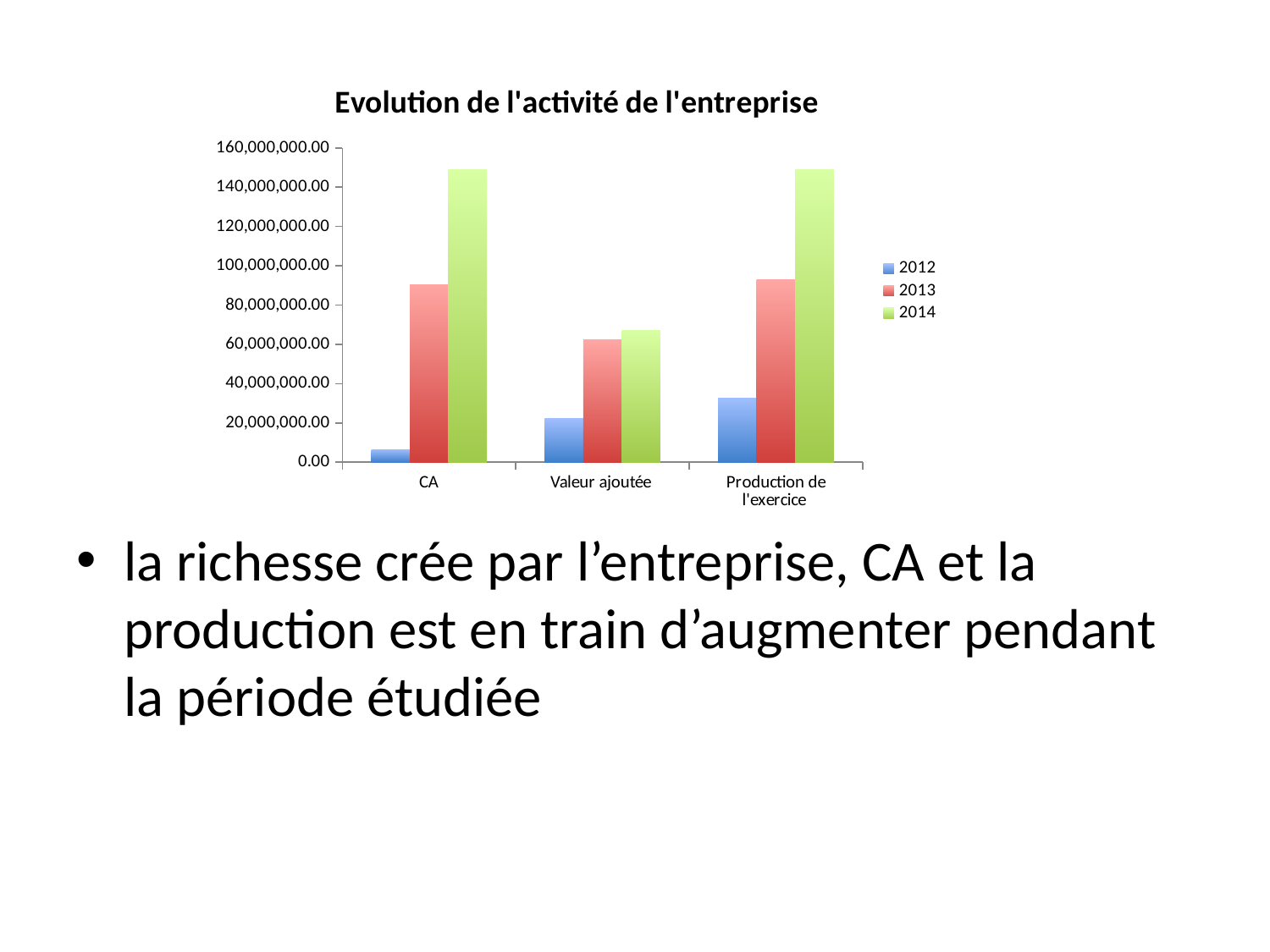
What kind of chart is shown on the slide? bar chart What is the title of the chart? Evolution de l'activité de l'entreprise Which is larger: the 2013 value for CA or the 2013 value for Valeur ajoutée? CA Is the value for Production de l'exercice in 2013 greater or less than 80,000,000.00? greater Which is larger: the 2012 value for Production de l'exercice or the 2012 value for CA? Production de l'exercice How many categories are shown on the x axis? 3 Is the value for CA in 2014 greater or less than 140,000,000.00? greater Which year has the lowest value for CA? 2012 How many series does the legend list? 3 Is the value for Valeur ajoutée in 2012 greater or less than 40,000,000.00? less Do the values for CA rise or fall from 2012 to 2014? rise Which year has the highest value for Production de l'exercice? 2014